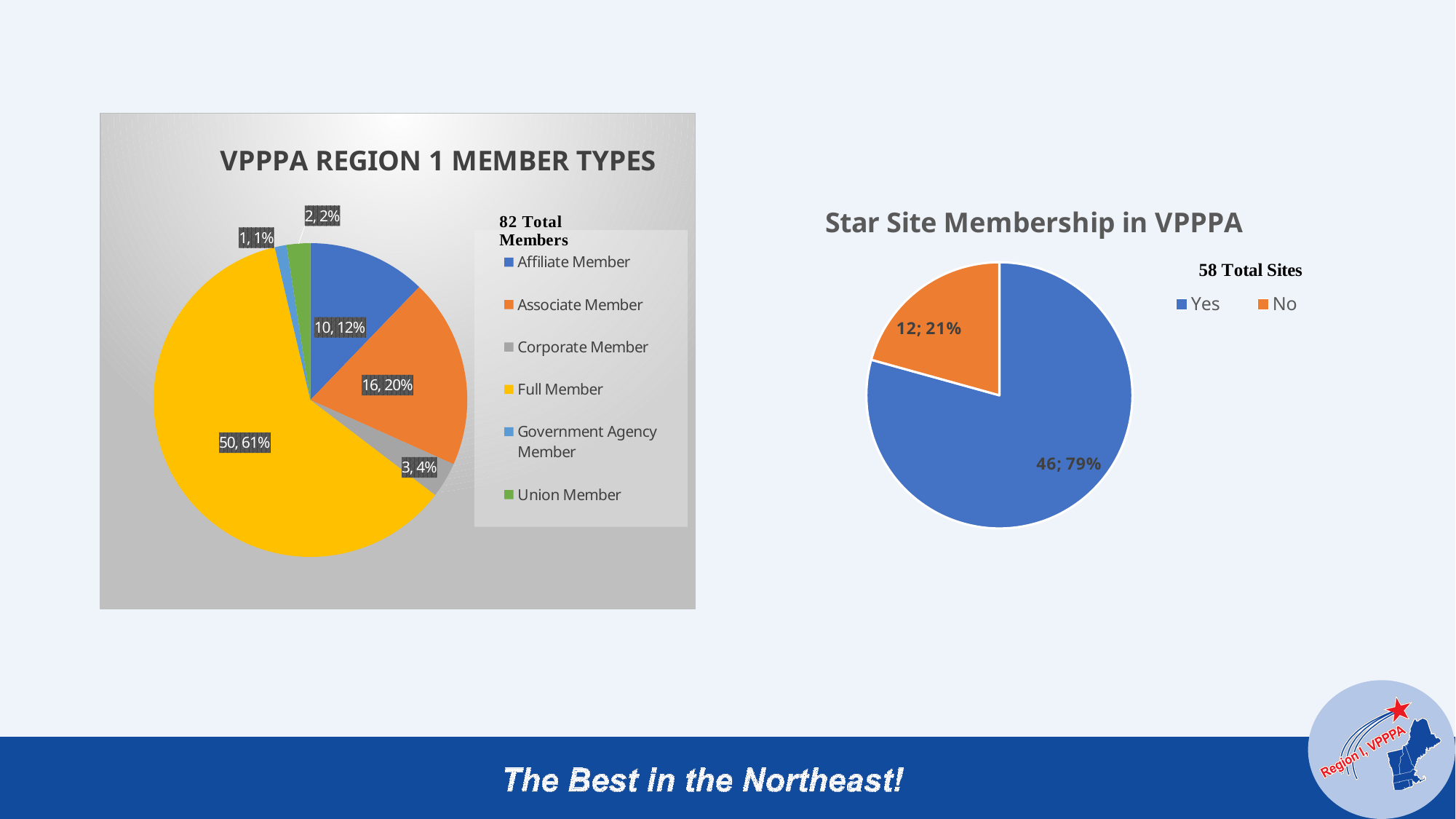
In the 'VPPPA REGION 1 MEMBER TYPES' chart, how many member types are shown in the legend? 6 In the 'VPPPA REGION 1 MEMBER TYPES' chart, what is the difference in count between Associate Member and Affiliate Member? 6 In the 'Star Site Membership in VPPPA' chart, what is the value shown for Yes? 46; 79% In the 'VPPPA REGION 1 MEMBER TYPES' chart, which member type has the largest slice? Full Member In the 'Star Site Membership in VPPPA' chart, how many total sites are stated? 58 In the 'Star Site Membership in VPPPA' chart, what share of the pie is No? 21% In the 'VPPPA REGION 1 MEMBER TYPES' chart, what is the value shown for Full Member? 50, 61% In the 'VPPPA REGION 1 MEMBER TYPES' chart, which is larger, Affiliate Member or Union Member? Affiliate Member In the 'VPPPA REGION 1 MEMBER TYPES' chart, what is the value shown for Associate Member? 16, 20% In the 'VPPPA REGION 1 MEMBER TYPES' chart, what is the value shown for Corporate Member? 3, 4% In the 'VPPPA REGION 1 MEMBER TYPES' chart, which member type has the smallest slice? Government Agency Member What kind of chart is 'Star Site Membership in VPPPA'? Pie chart